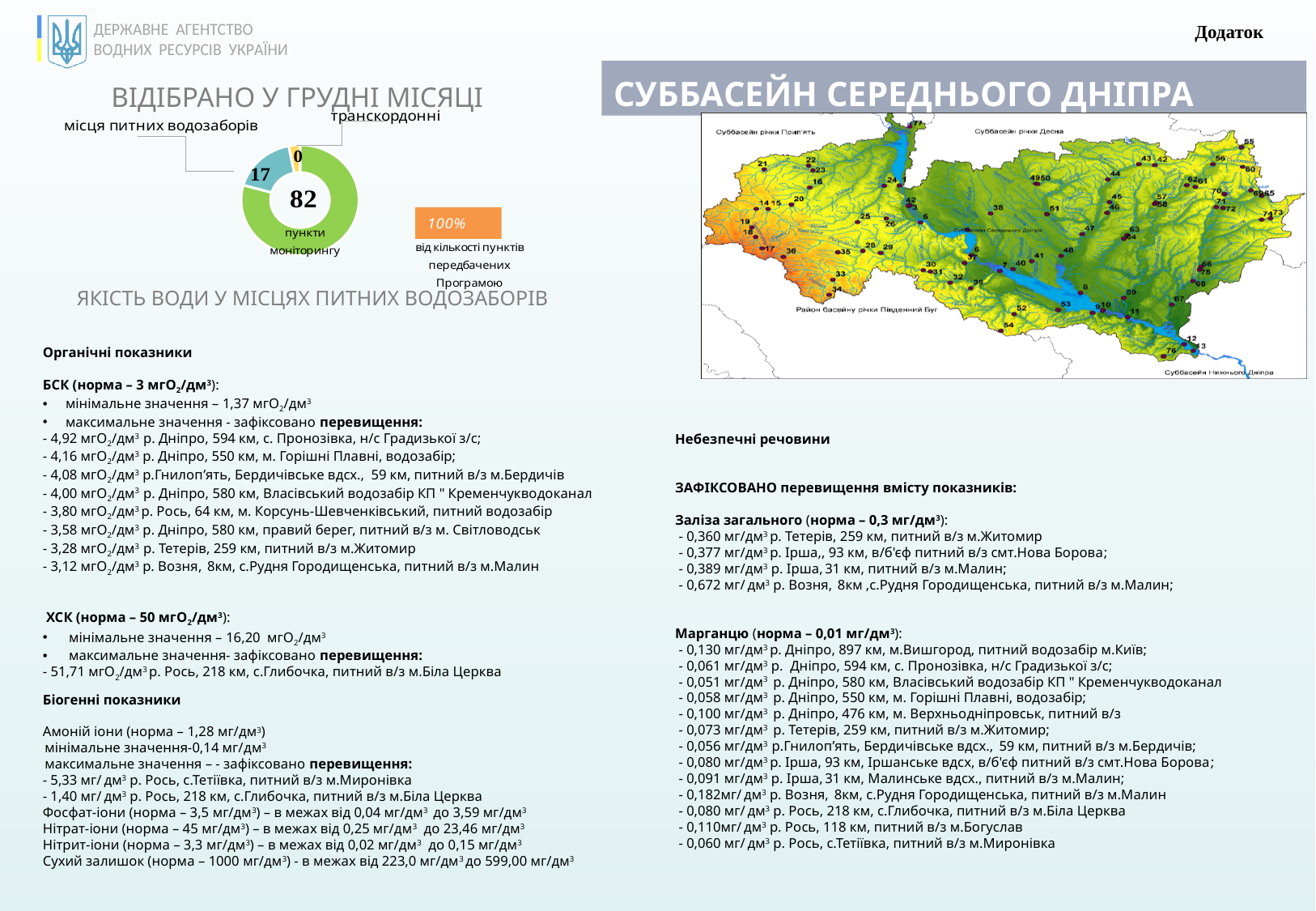
What number is printed in the centre of the doughnut chart for "пункти моніторингу"? 82 Is the value for "місця питних водозаборів" in the doughnut chart greater or less than 10? greater In the doughnut chart, what value is shown for "місця питних водозаборів"? 17 In the doughnut chart, what value is shown for "транскордонні"? 0 How many segments (categories) does the doughnut chart show? 3 What kind of chart is shown under the heading "ВІДІБРАНО У ГРУДНІ МІСЯЦІ"? doughnut (pie) chart In the doughnut chart, what is the difference between the values for "місця питних водозаборів" and "транскордонні"? 17 What is the title above the doughnut chart? ВІДІБРАНО У ГРУДНІ МІСЯЦІ Which labelled segment of the doughnut chart has the smallest value? транскордонні In the doughnut chart, which is larger: "місця питних водозаборів" or "транскордонні"? місця питних водозаборів What colour is the largest segment of the doughnut chart? green